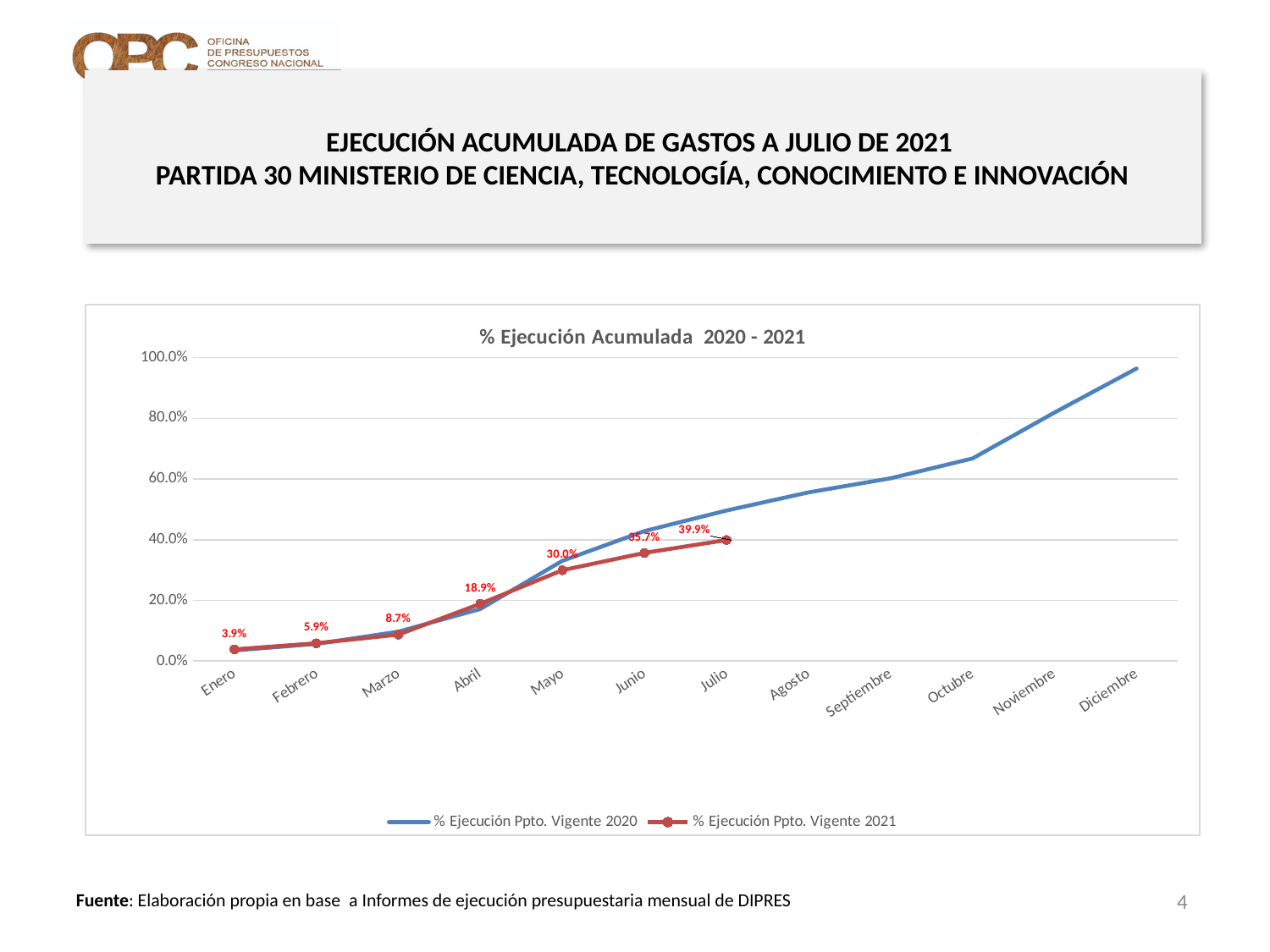
What is the title of the chart? % Ejecución Acumulada 2020 - 2021 What type of chart is shown on the slide? Line chart In Julio, which series has the larger value, % Ejecución Ppto. Vigente 2020 or % Ejecución Ppto. Vigente 2021? % Ejecución Ppto. Vigente 2020 What is the value of % Ejecución Ppto. Vigente 2021 for Julio? 39.9% What is the difference between the % Ejecución Ppto. Vigente 2021 values for Mayo and Abril? 11.1% Is the value of % Ejecución Ppto. Vigente 2020 for Diciembre greater or less than 80.0%? greater How many months are shown on the x axis? 12 What is the value of % Ejecución Ppto. Vigente 2021 for Enero? 3.9% How many series does the legend list? 2 Does the % Ejecución Ppto. Vigente 2021 series rise or fall from Enero to Julio? Rise What is the value of % Ejecución Ppto. Vigente 2021 for Abril? 18.9% In which month is the % Ejecución Ppto. Vigente 2021 series highest? Julio